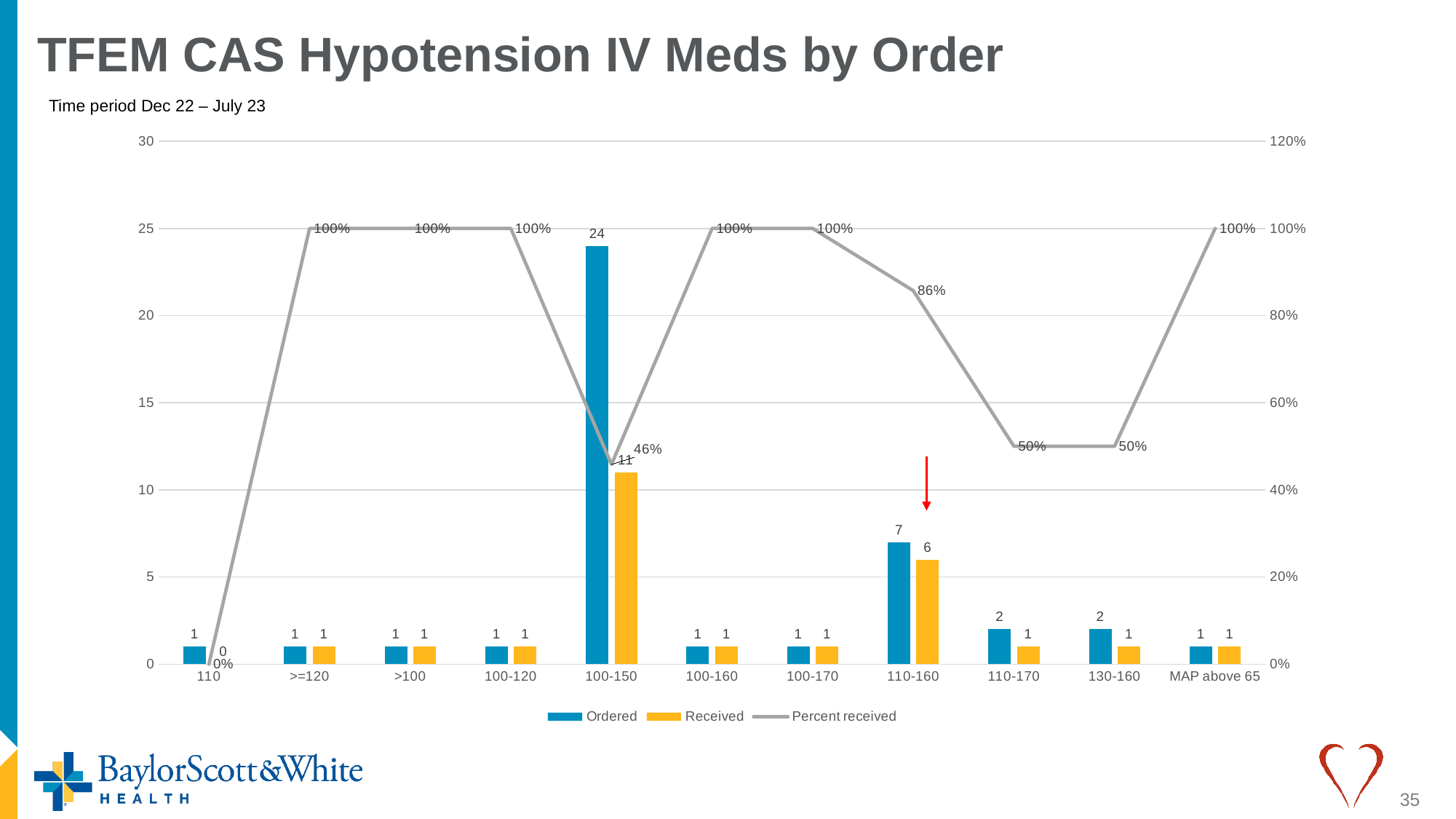
What is the Percent received for the 130-160 category? 50% How many categories are shown on the x axis? 11 Which is larger, the Ordered value for 110-160 or the Ordered value for 110-170? 110-160 What is the Received value for the 110-160 category? 6 What is the difference between Ordered and Received for the 100-150 category? 13 What is the time period stated on the slide? Dec 22 – July 23 How many series does the legend list? 3 Which category has the highest Ordered value? 100-150 What is the Percent received for the 110-160 category? 86% Which category has the lowest Percent received? 110 How many Ordered were there for the 100-150 category? 24 What is the Percent received for the 100-150 category? 46%